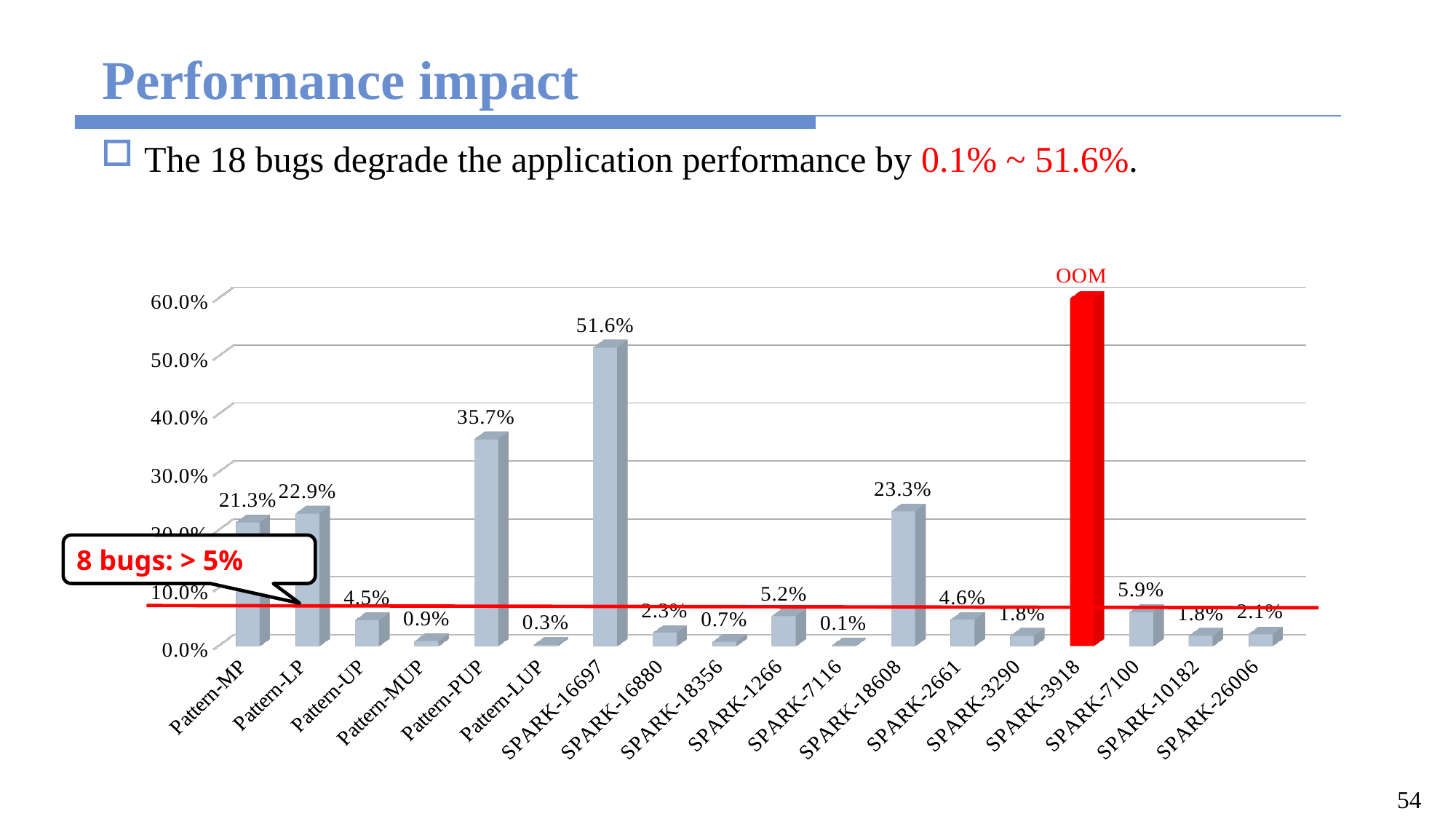
What is the performance degradation value shown for SPARK-16697? 51.6% Which category has the highest labeled percentage value in the chart? SPARK-16697 What value is shown for Pattern-PUP? 35.7% What label is shown above the red bar for SPARK-3918? OOM What does the callout box on the chart say? 8 bugs: > 5% What is the difference between the values for Pattern-LP and Pattern-MP? 1.6% Which category has the lowest percentage value in the chart? SPARK-7116 What kind of chart is shown on the slide? bar chart How many categories are shown on the x axis of the chart? 18 Is the value for Pattern-PUP greater or less than 30.0%? greater What value is shown for SPARK-18608? 23.3% Which is larger, the value for SPARK-1266 or the value for SPARK-2661? SPARK-1266